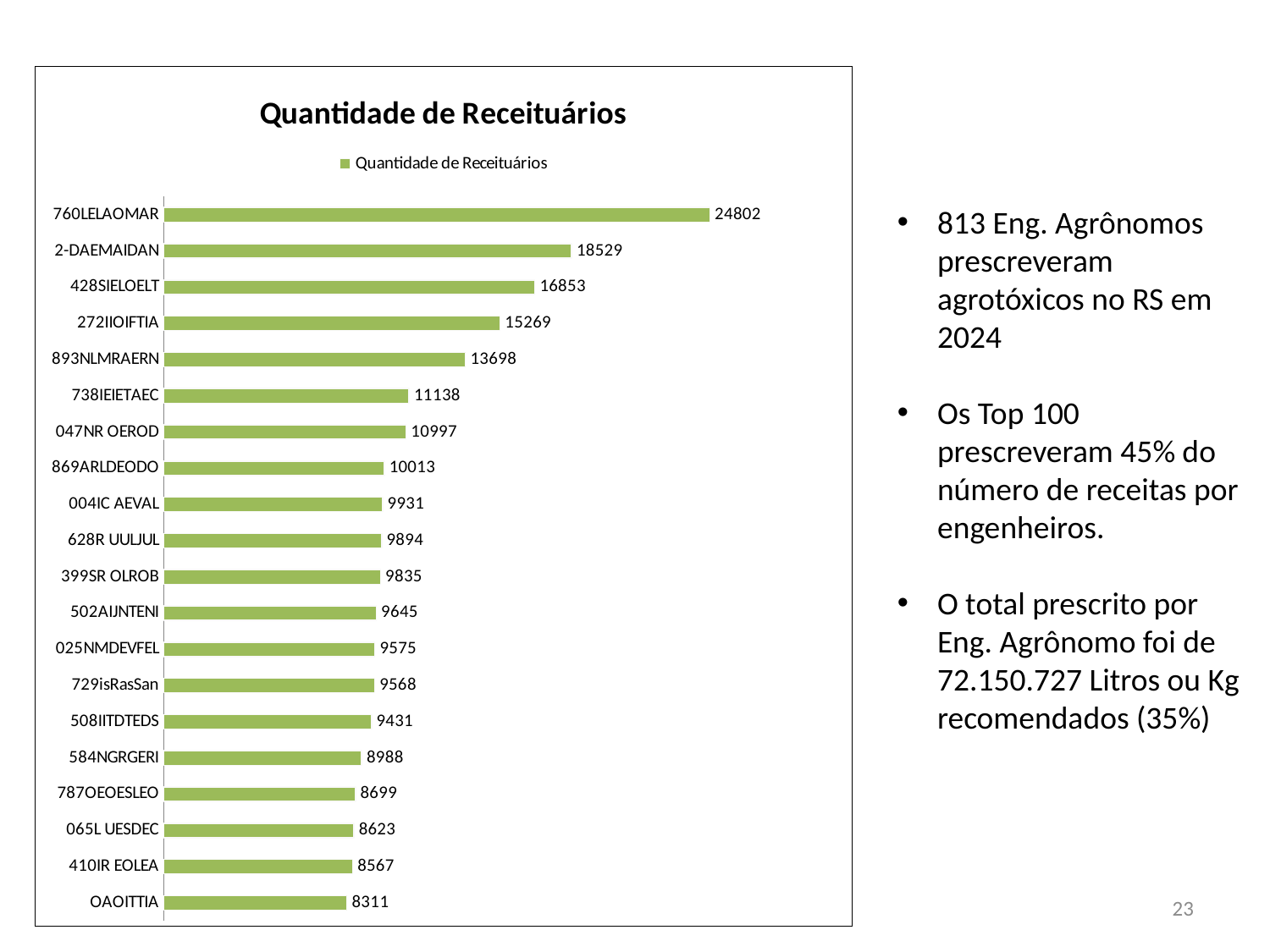
What is the value for 760LELAOMAR? 24802 What is the value for 893NLMRAERN? 13698 How many categories are shown in the chart? 20 What is the difference between the values for 428SIELOELT and 272IIOIFTIA? 1584 What is the difference between the values for 760LELAOMAR and 2-DAEMAIDAN? 6273 How many series does the legend list? 1 What kind of chart is shown on the slide? Bar chart Which is larger, the value for 738IEIETAEC or the value for 869ARLDEODO? 738IEIETAEC What is the value for 584NGRGERI? 8988 Which category has the highest value? 760LELAOMAR Which category has the lowest value? OAOITTIA What is the title of the chart? Quantidade de Receituários